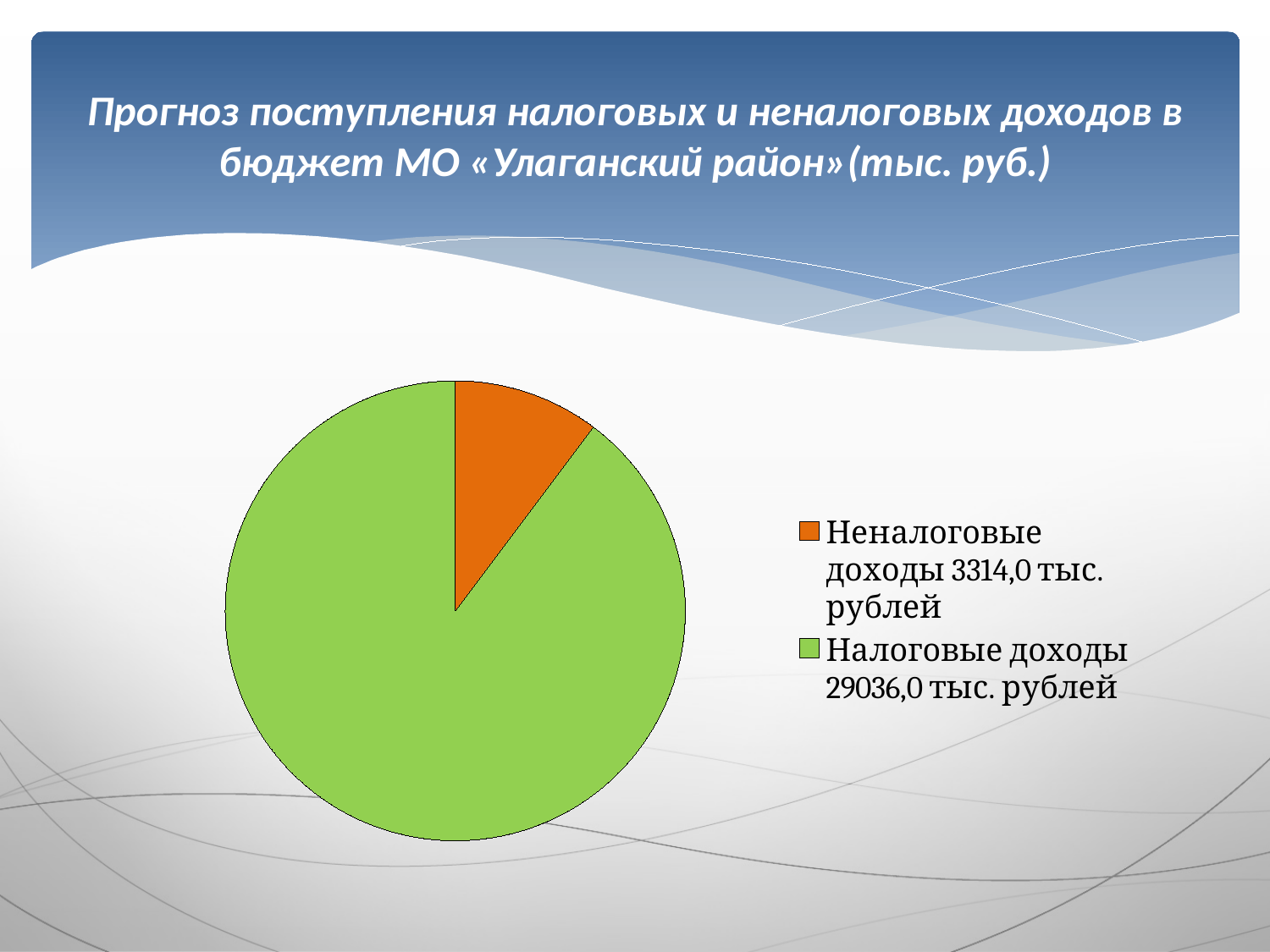
What colour is the slice for Неналоговые доходы? Orange What kind of chart is shown on the slide? Pie chart What is the value for Налоговые доходы? 29036,0 тыс. рублей What colour is the slice for Налоговые доходы? Green Which category has the smallest slice of the pie? Неналоговые доходы Which is larger, Налоговые доходы or Неналоговые доходы? Налоговые доходы What share of the total do Неналоговые доходы represent? 10.2% How many slices does the pie chart have? 2 Which category has the largest slice of the pie? Налоговые доходы What is the value for Неналоговые доходы? 3314,0 тыс. рублей What is the total of the two categories in the pie chart? 32350,0 тыс. рублей What is the difference between Налоговые доходы and Неналоговые доходы? 25722,0 тыс. рублей